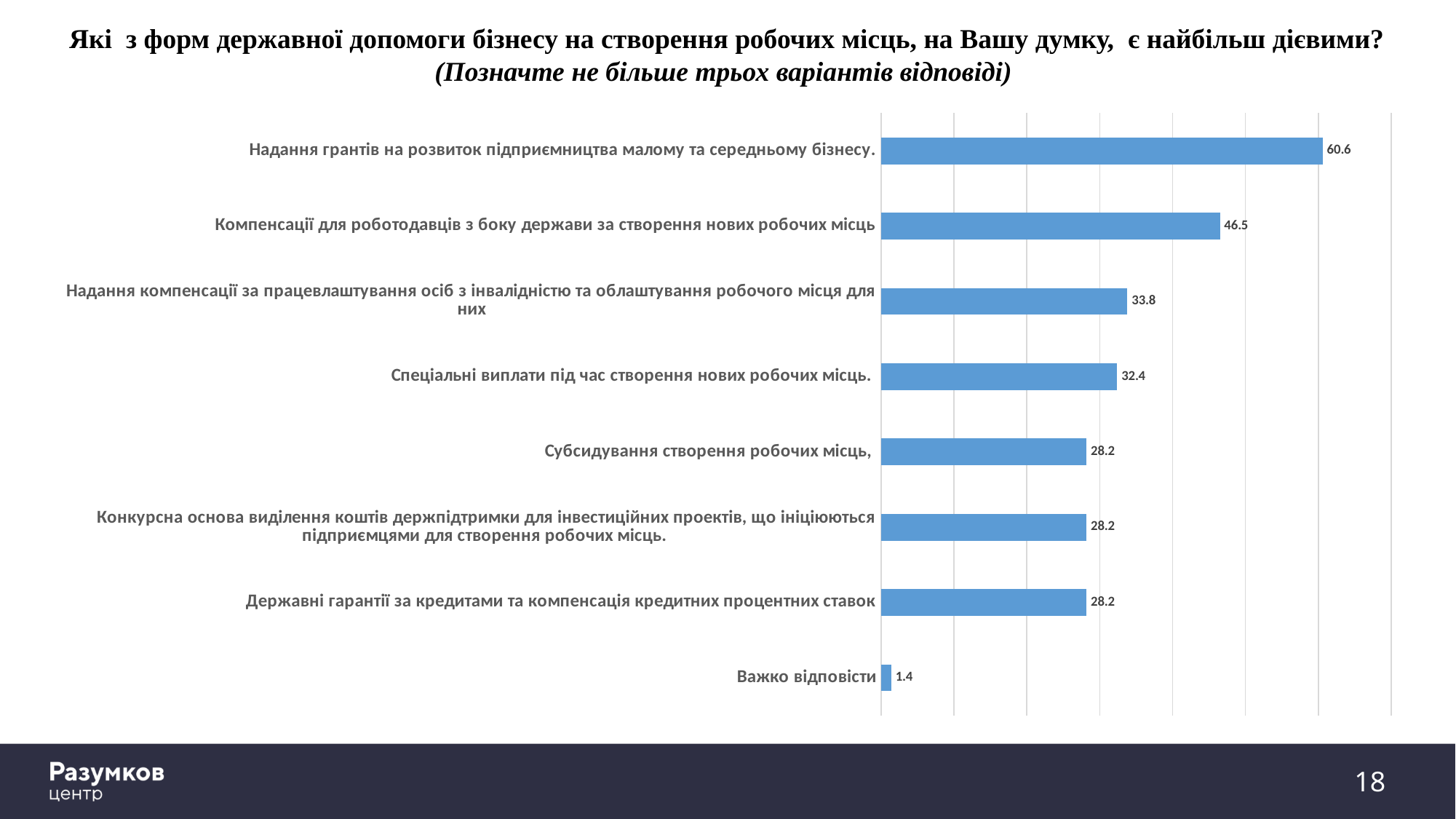
What is the value for "Компенсації для роботодавців з боку держави за створення нових робочих місць"? 46.5 What is the value for "Надання грантів на розвиток підприємництва малому та середньому бізнесу"? 60.6 What is the value for "Важко відповісти"? 1.4 Which category has the lowest value? Важко відповісти What is the value for "Спеціальні виплати під час створення нових робочих місць"? 32.4 What kind of chart is shown on the slide? Bar chart What is the difference between the values for "Надання компенсації за працевлаштування осіб з інвалідністю та облаштування робочого місця для них" and "Спеціальні виплати під час створення нових робочих місць"? 1.4 How many categories share the value 28.2? 3 Which is larger: the value for "Компенсації для роботодавців з боку держави за створення нових робочих місць" or the value for "Субсидування створення робочих місць"? Компенсації для роботодавців з боку держави за створення нових робочих місць How many categories are shown in the chart? 8 Which category has the highest value? Надання грантів на розвиток підприємництва малому та середньому бізнесу What is the difference between the values for "Надання грантів на розвиток підприємництва малому та середньому бізнесу" and "Компенсації для роботодавців з боку держави за створення нових робочих місць"? 14.1